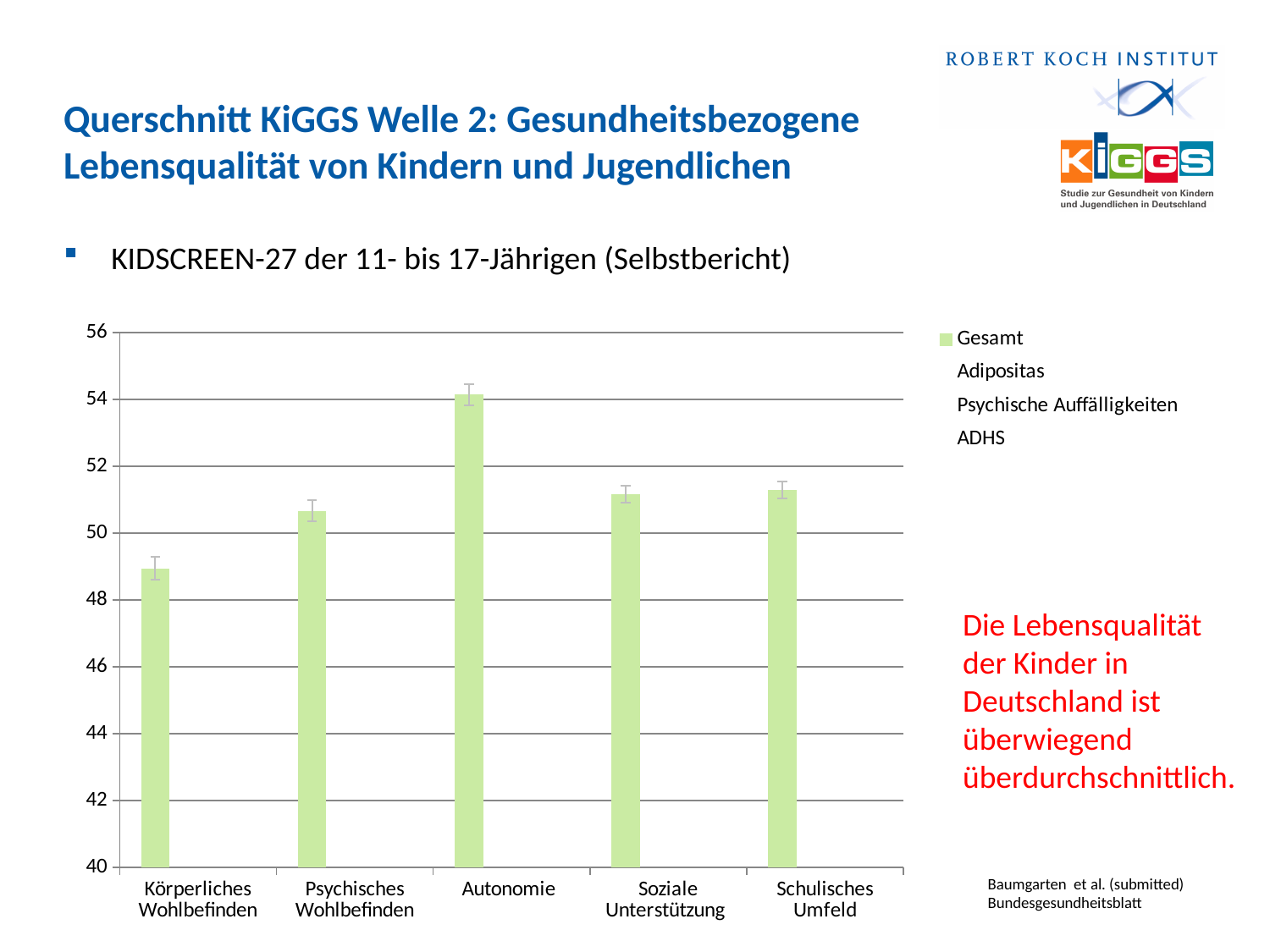
How many entries does the chart legend list? 4 Which is larger, the value for Psychisches Wohlbefinden or the value for Körperliches Wohlbefinden? Psychisches Wohlbefinden Is the value for Schulisches Umfeld greater or less than 52? less Is the value for Körperliches Wohlbefinden greater or less than 50? less What is the first entry in the chart legend? Gesamt Which is larger, the value for Autonomie or the value for Soziale Unterstützung? Autonomie How many categories are shown on the x axis of the chart? 5 Is the value for Autonomie greater or less than 52? greater Which category has the lowest bar in the chart? Körperliches Wohlbefinden What kind of chart is shown on the slide? bar chart Which category has the highest bar in the chart? Autonomie